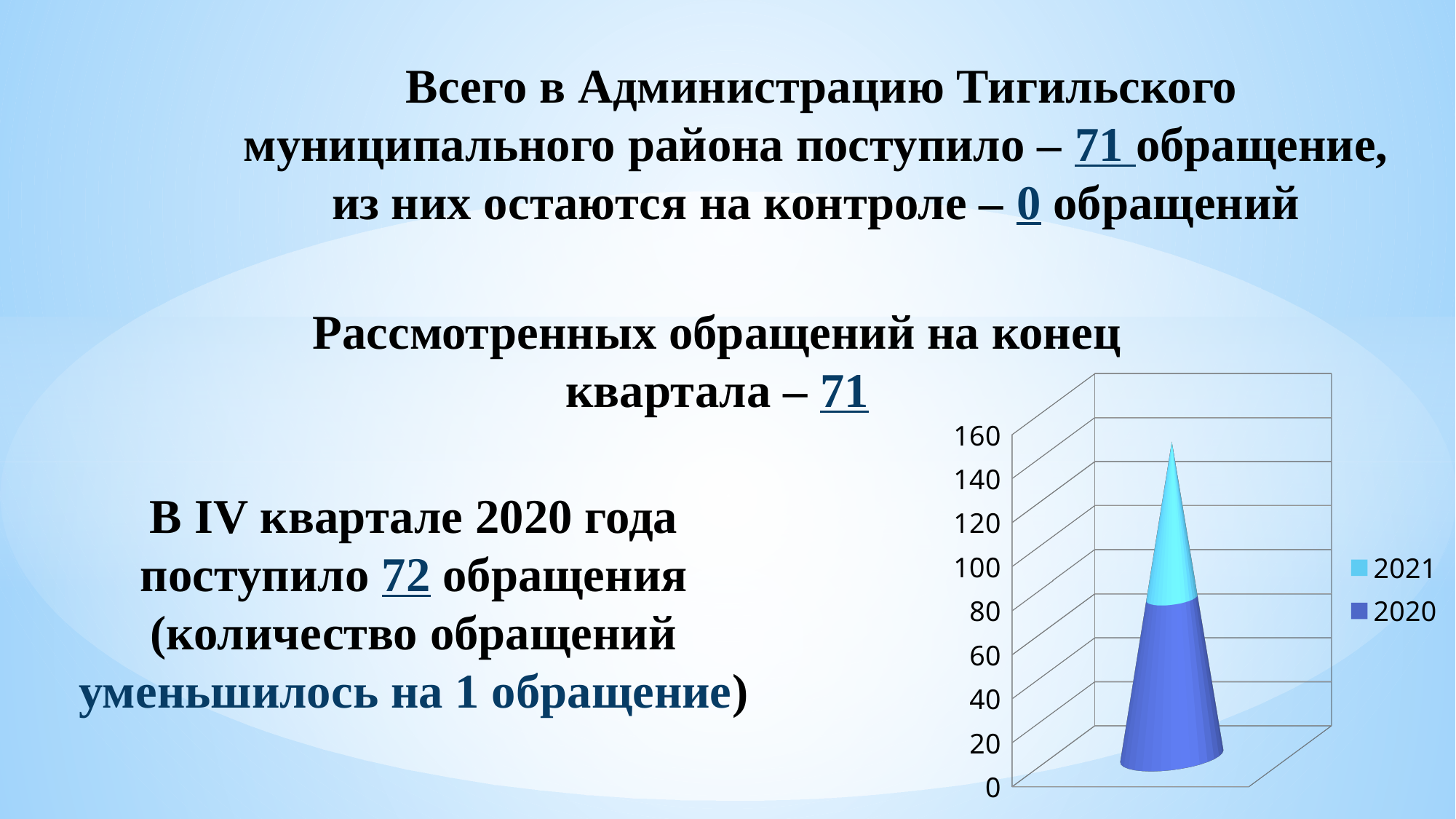
Which series forms the top segment of the stacked bar? 2021 How many bars are plotted in the chart? 1 Is the total height of the stacked bar greater or less than 100? greater How many series does the chart legend list? 2 Which series is shown in the lighter blue colour in the chart legend? 2021 Is the total height of the stacked bar greater or less than 160? less What kind of chart is shown on the slide? bar chart Is the value of the 2021 segment of the bar greater or less than 20? greater